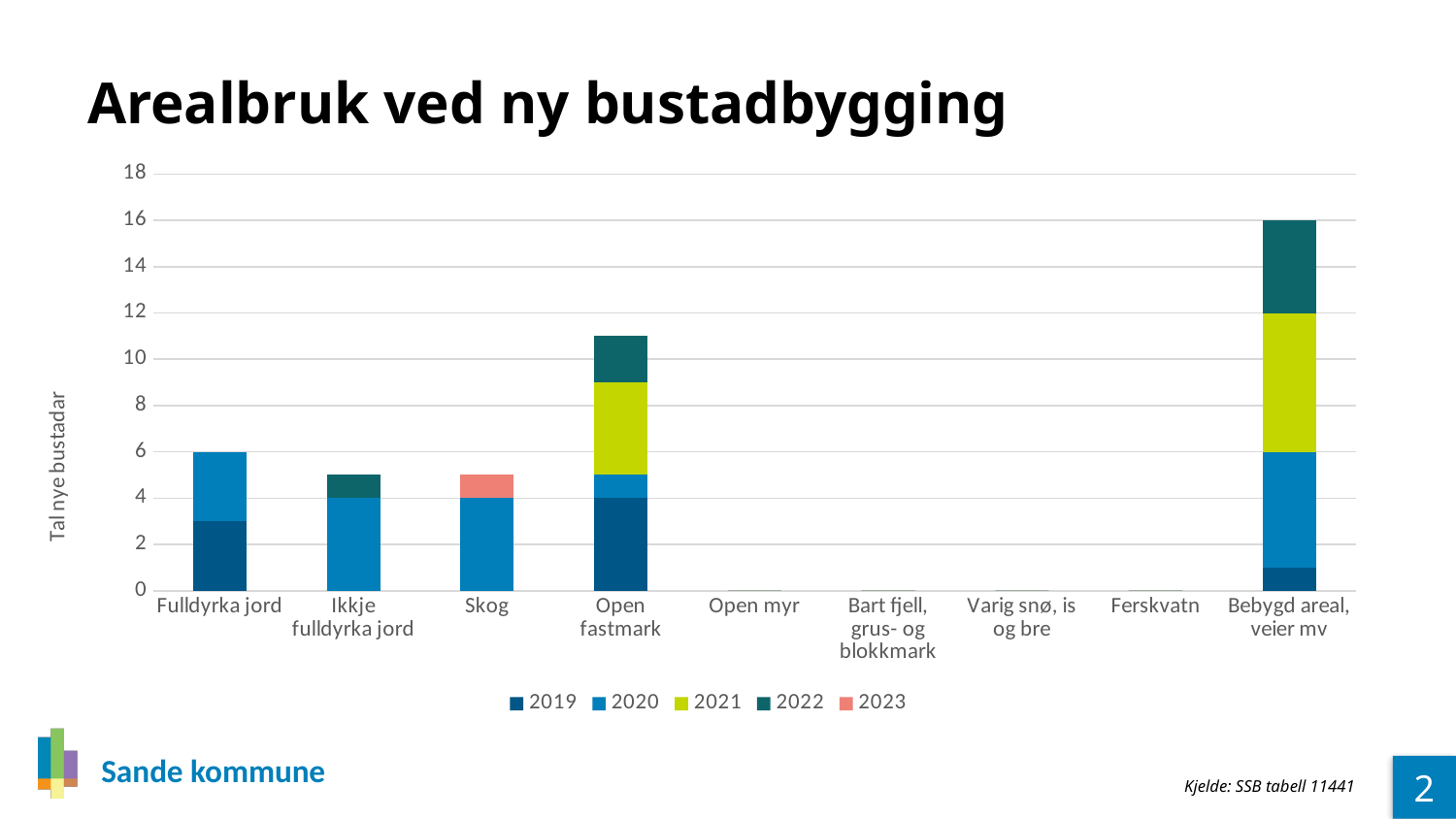
What is the value of the 2019 segment for Open fastmark? 4 How many categories are shown on the x axis? 9 Which has a taller stacked bar, Open fastmark or Fulldyrka jord? Open fastmark What is the total height of the stacked bar for Bebygd areal, veier mv? 16 Is the total for Skog greater or less than 6? less What is the title of the chart? Arealbruk ved ny bustadbygging How many series does the legend list? 5 What type of chart is shown on the slide? Stacked bar chart What is the total height of the stacked bar for Fulldyrka jord? 6 Which year in the legend is shown in salmon/pink? 2023 Is the total for Open fastmark greater or less than 10? greater Which category has the tallest stacked bar? Bebygd areal, veier mv